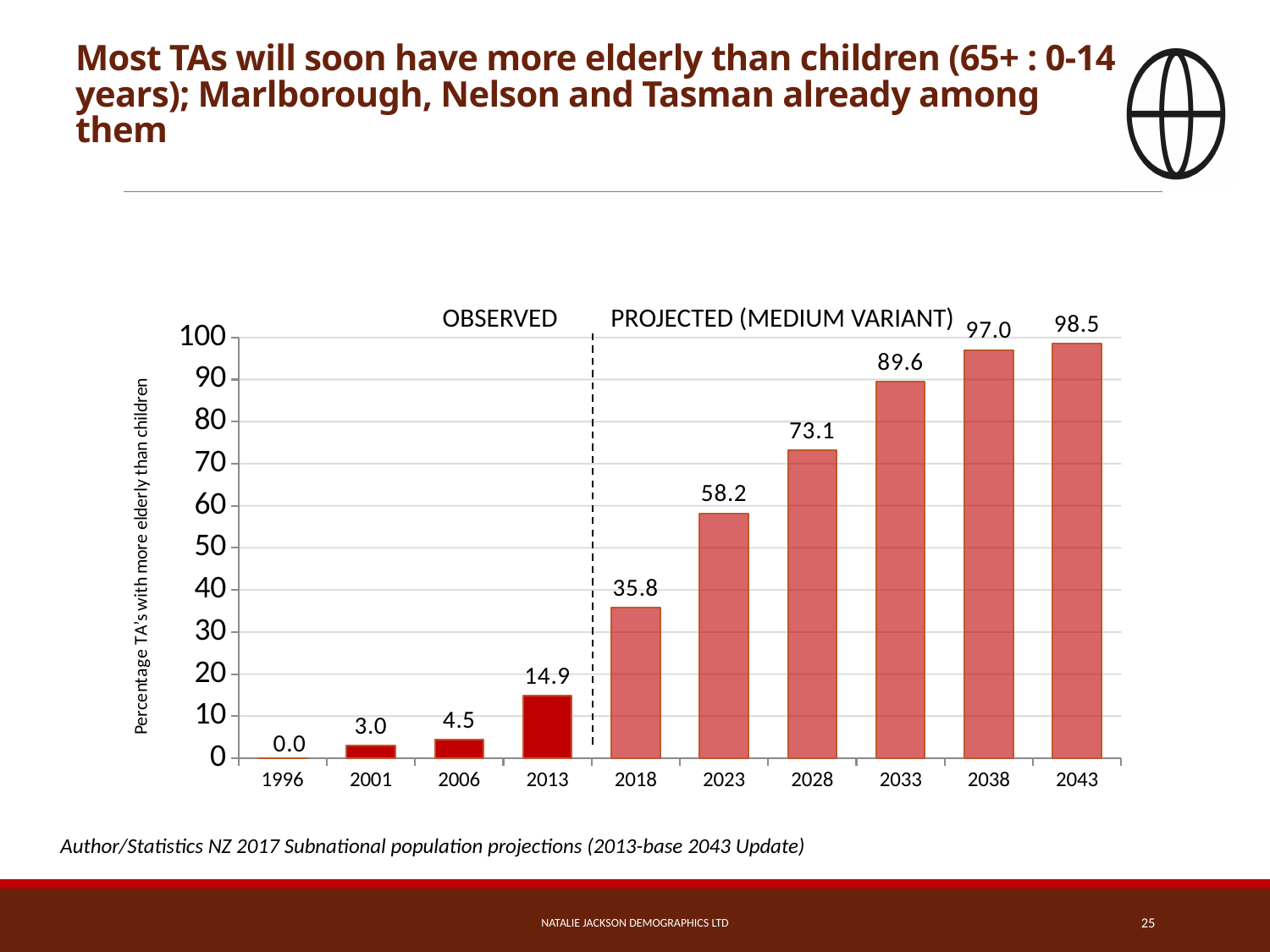
Which year has the highest value? 2043 Is the value for 2033 greater or less than 80? greater How many years are shown on the x axis? 10 What is the label of the y axis? Percentage TA's with more elderly than children What is the difference between the values for 2023 and 2018? 22.4 Which year has the lowest value? 1996 Do the values rise or fall from 1996 to 2043? Rise What is the value for 2043? 98.5 What is the value for 2013? 14.9 What is the value for 2028? 73.1 Which is larger, the value for 2006 or the value for 2001? 2006 What kind of chart is shown on the slide? Bar chart